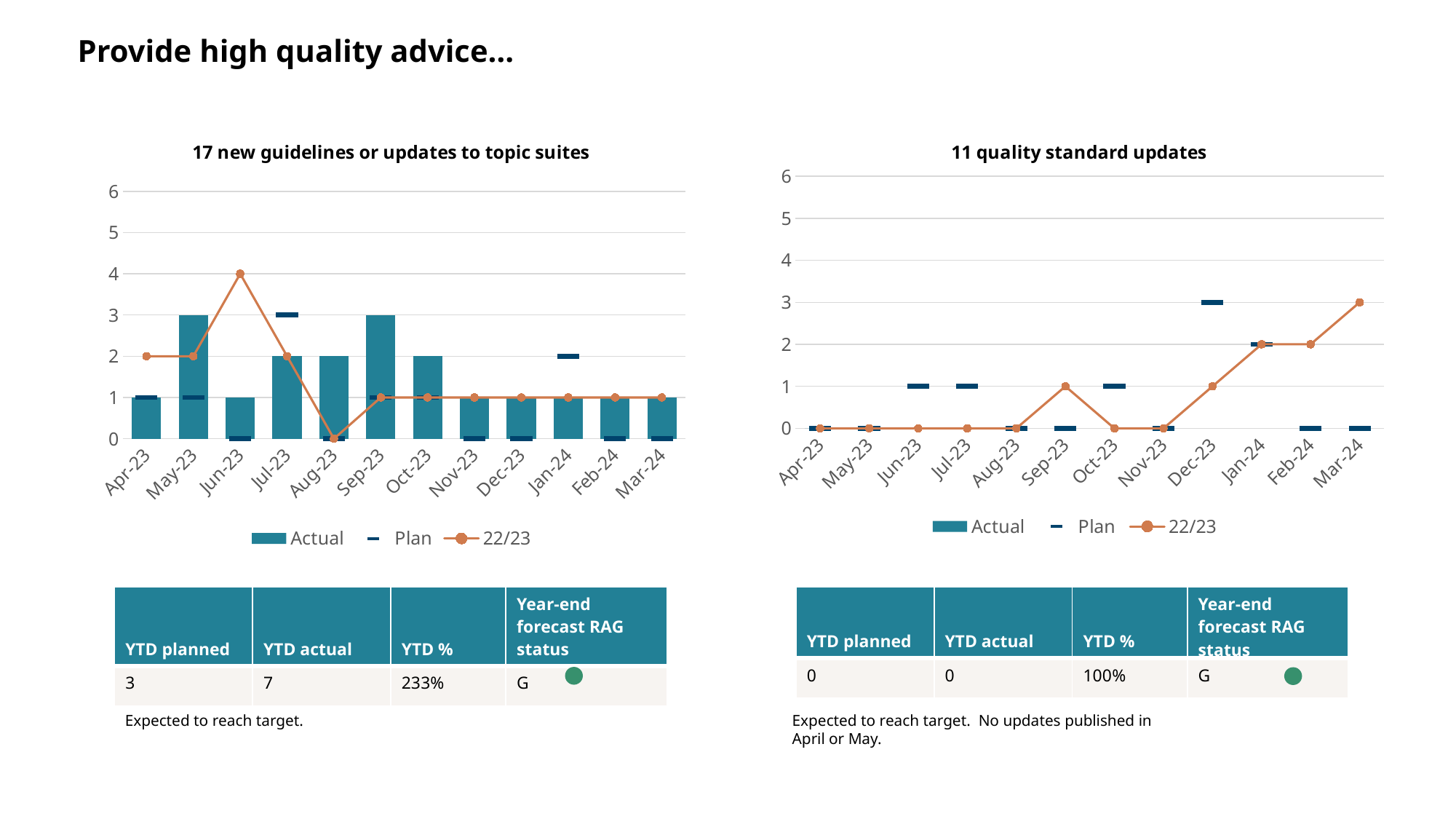
In the '17 new guidelines or updates to topic suites' chart, which is larger, the Actual value for Jul-23 or the Actual value for Nov-23? Jul-23 In the '11 quality standard updates' chart, what is the Plan value for Dec-23? 3 In the '17 new guidelines or updates to topic suites' chart, in which month does the 22/23 line reach its highest value? Jun-23 How many months are shown on the x axis of the '17 new guidelines or updates to topic suites' chart? 12 In the '17 new guidelines or updates to topic suites' chart, what is the Plan value for Jul-23? 3 In the '17 new guidelines or updates to topic suites' chart, what is the difference between the 22/23 value and the Actual value for Jun-23? 3 In the '11 quality standard updates' chart, does the 22/23 line rise or fall from Nov-23 to Mar-24? rise In the '17 new guidelines or updates to topic suites' chart, what is the Actual value for May-23? 3 What kind of chart is the '17 new guidelines or updates to topic suites' chart? bar and line chart In the '17 new guidelines or updates to topic suites' chart, what is the 22/23 value for Aug-23? 0 In the '11 quality standard updates' chart, what is the 22/23 value for Mar-24? 3 How many series does the legend of the '11 quality standard updates' chart list? 3